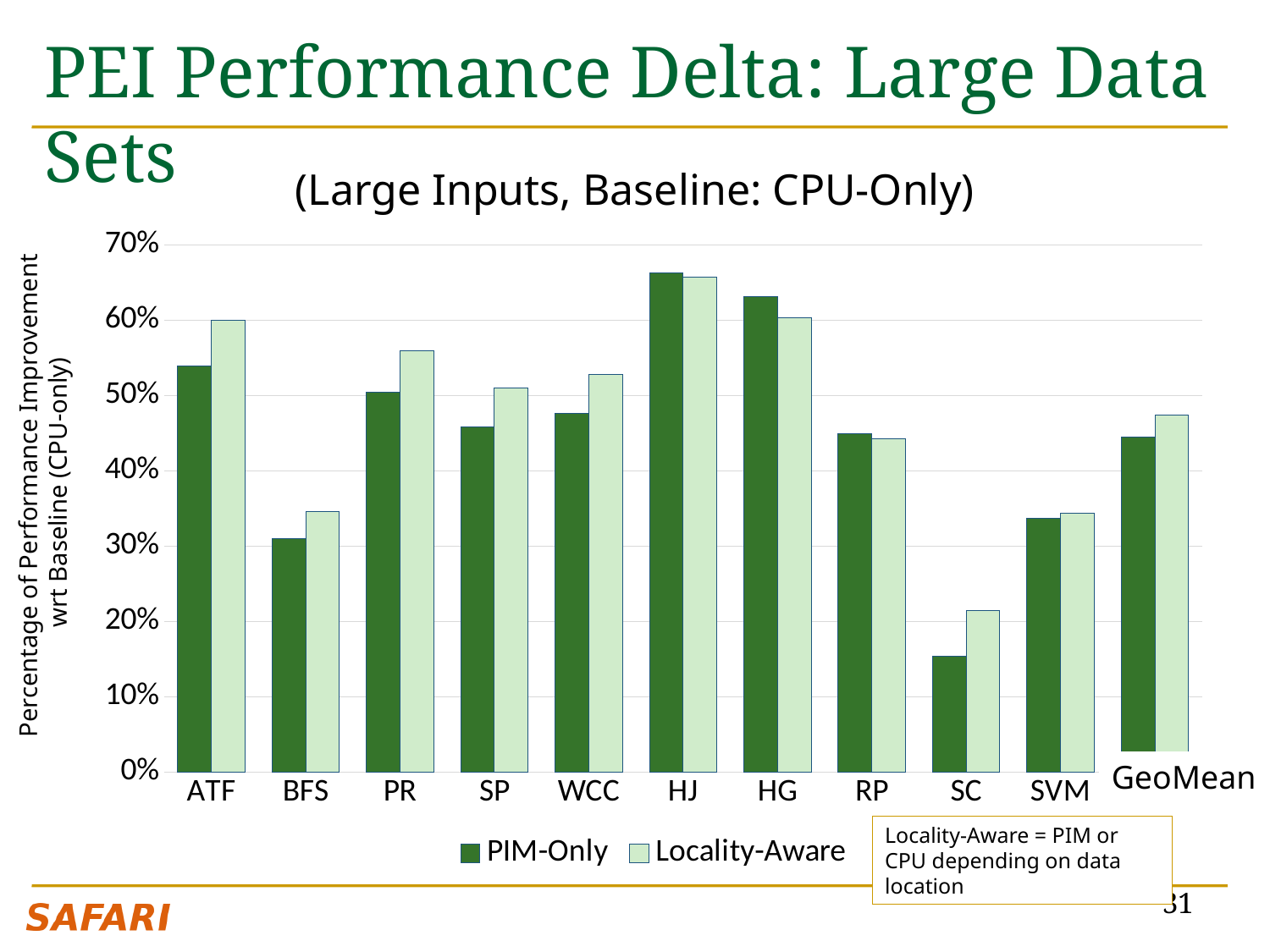
Which category has the highest PIM-Only value? HJ How many categories are shown on the x axis? 11 How many series does the legend list? 2 Is the Locality-Aware value for SC greater or less than 20%? greater For HG, which is larger: the PIM-Only value or the Locality-Aware value? PIM-Only Is the PIM-Only value for HJ greater or less than 60%? greater What kind of chart is shown on the slide? bar chart Which category has the lowest Locality-Aware value? SC Is the PIM-Only value for SC greater or less than 20%? less Which category has the lowest PIM-Only value? SC For ATF, which is larger: the PIM-Only value or the Locality-Aware value? Locality-Aware